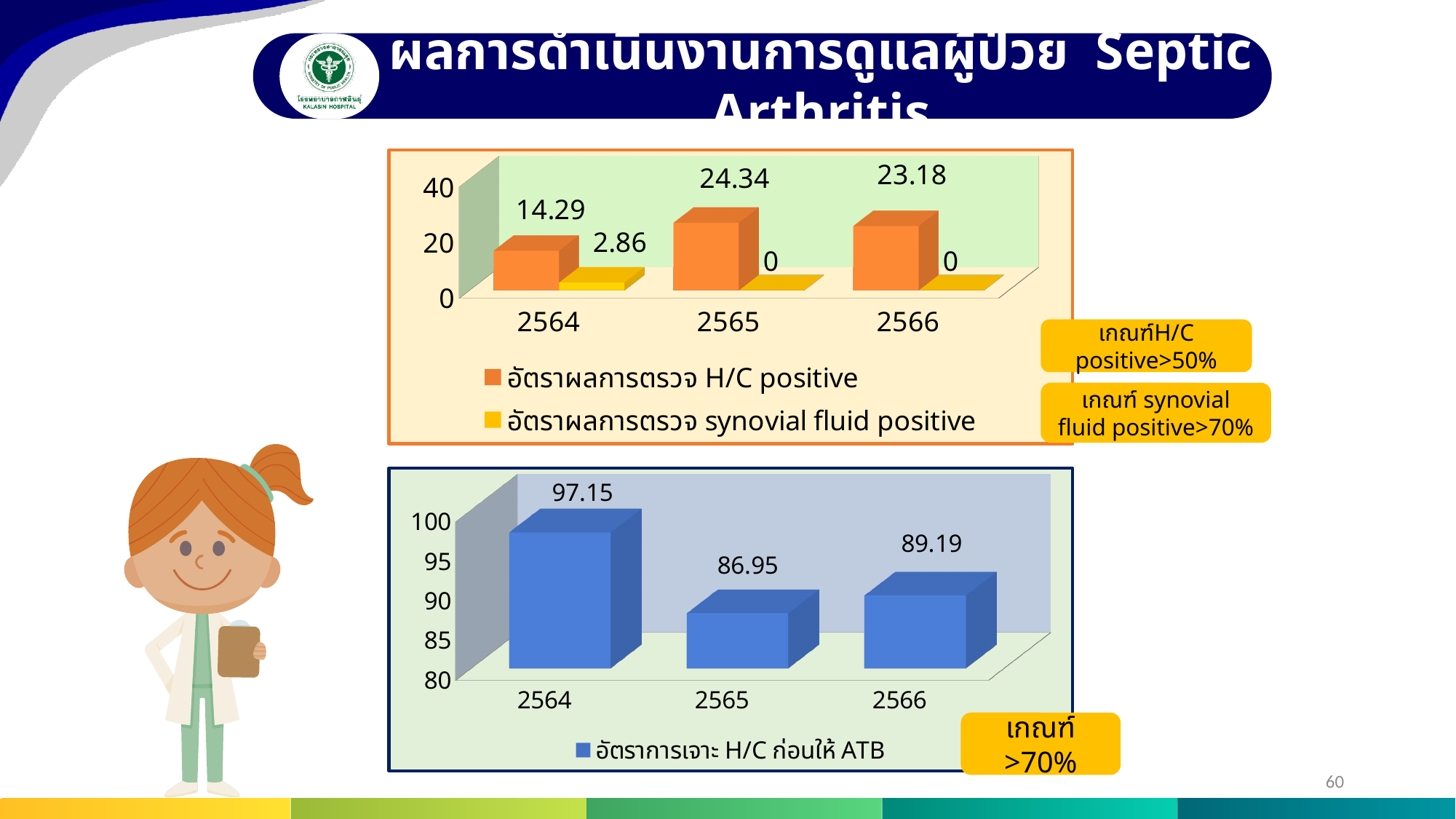
In the top chart, what is the value of อัตราผลการตรวจ synovial fluid positive for 2566? 0 In the bottom chart, which year has the lowest value? 2565 In the bottom chart, how many years are shown on the x axis? 3 In the bottom chart, what is the difference between the values for 2564 and 2566? 7.96 In the top chart, what is the value of อัตราผลการตรวจ H/C positive for 2565? 24.34 In the top chart, how many series does the legend list? 2 In the bottom chart, is the value for 2566 larger or smaller than the value for 2565? larger What kind of chart is the bottom chart? bar chart In the top chart, what is the difference between the H/C positive values for 2565 and 2564? 10.05 In the bottom chart, what is the value of อัตราการเจาะ H/C ก่อนให้ ATB for 2564? 97.15 In the top chart, which year has the highest value for อัตราผลการตรวจ H/C positive? 2565 In the top chart, what is the value of อัตราผลการตรวจ synovial fluid positive for 2564? 2.86